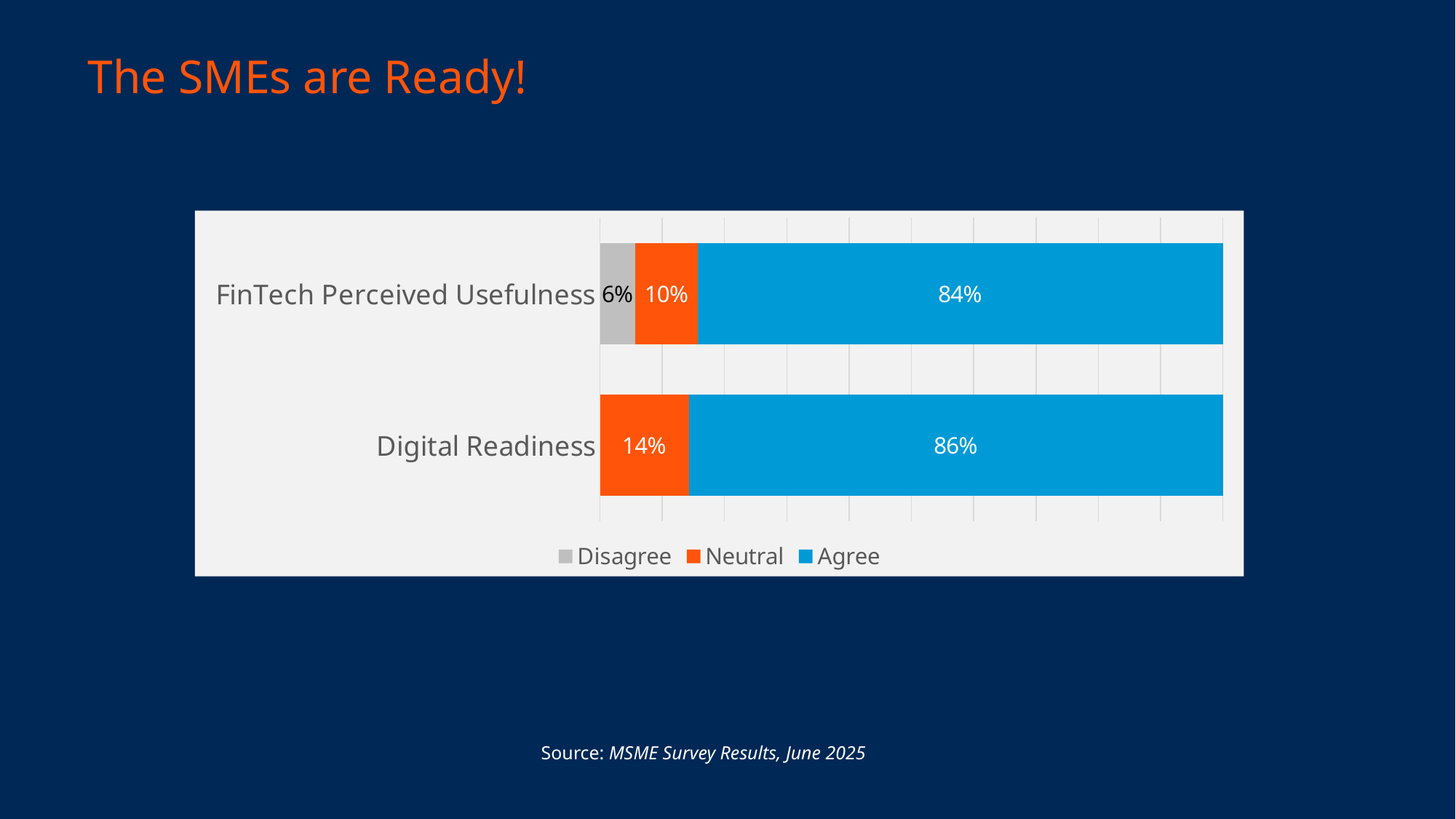
Which colour represents the Agree series in the chart? Blue What percentage of respondents agree on Digital Readiness? 86% What is the difference between the Agree percentages for Digital Readiness and FinTech Perceived Usefulness? 2% What percentage of respondents agree on FinTech Perceived Usefulness? 84% What percentage of respondents are neutral on Digital Readiness? 14% How many series does the legend list? 3 What percentage of respondents disagree on FinTech Perceived Usefulness? 6% Which category has the higher Agree percentage? Digital Readiness How many categories are shown in the chart? 2 What is the Neutral value for FinTech Perceived Usefulness? 10% What is the difference between the Neutral percentages for Digital Readiness and FinTech Perceived Usefulness? 4% What kind of chart is shown on the slide? Stacked bar chart